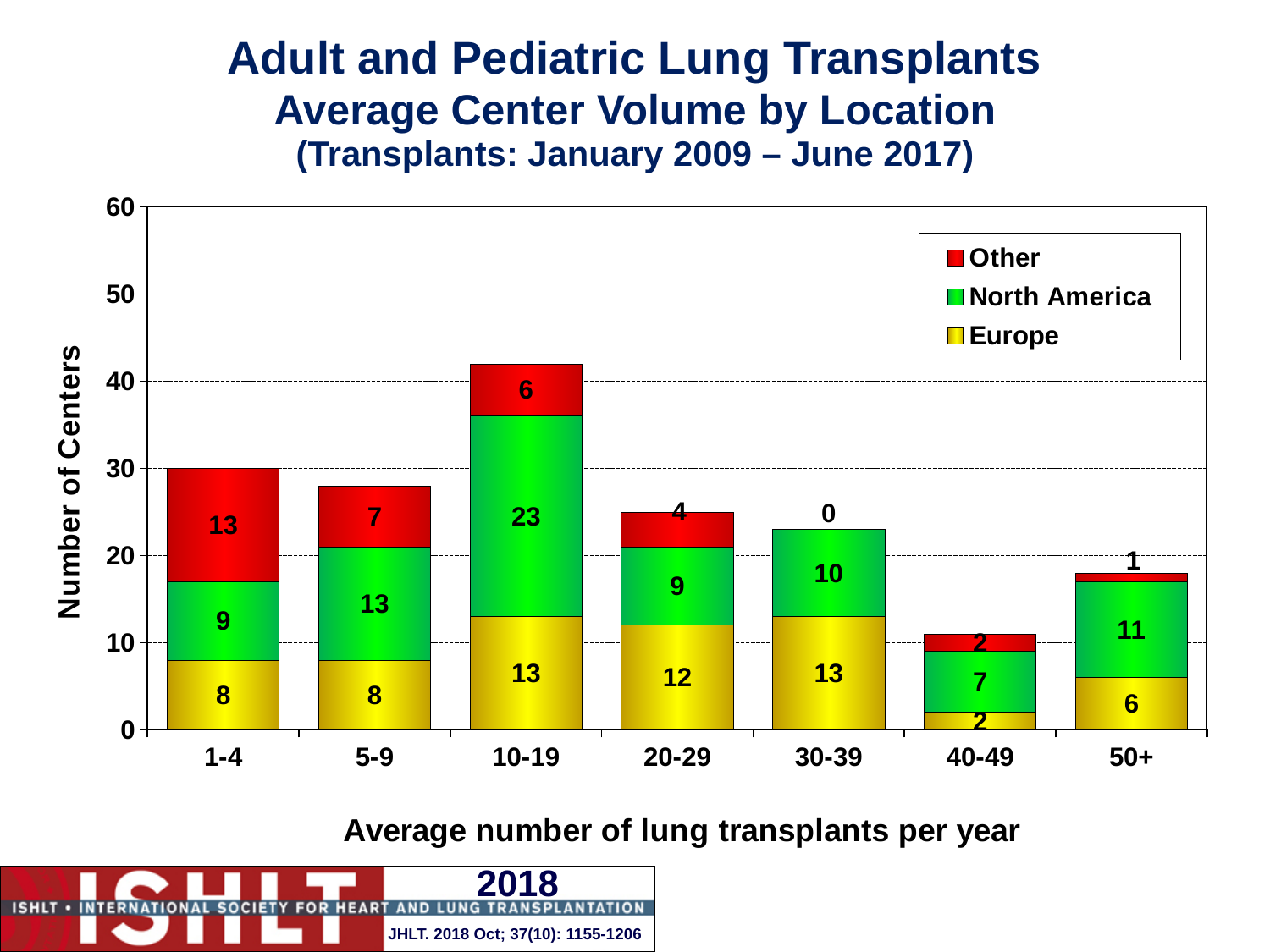
What is the total number of centers in the 10-19 category? 42 Which is larger, the Europe value for 30-39 or the Europe value for 50+? 30-39 How many volume categories are shown on the x axis? 7 Which category has the highest number of Other centers? 1-4 What is the difference between the North America values for the 10-19 and 5-9 categories? 10 What is the number of Other centers in the 30-39 category? 0 What is the label of the y axis? Number of Centers What is the number of Europe centers in the 20-29 category? 12 What type of chart is shown on the slide? Stacked bar chart Which category has the lowest total number of centers? 40-49 What is the number of North America centers in the 10-19 category? 23 How many series does the legend list? 3